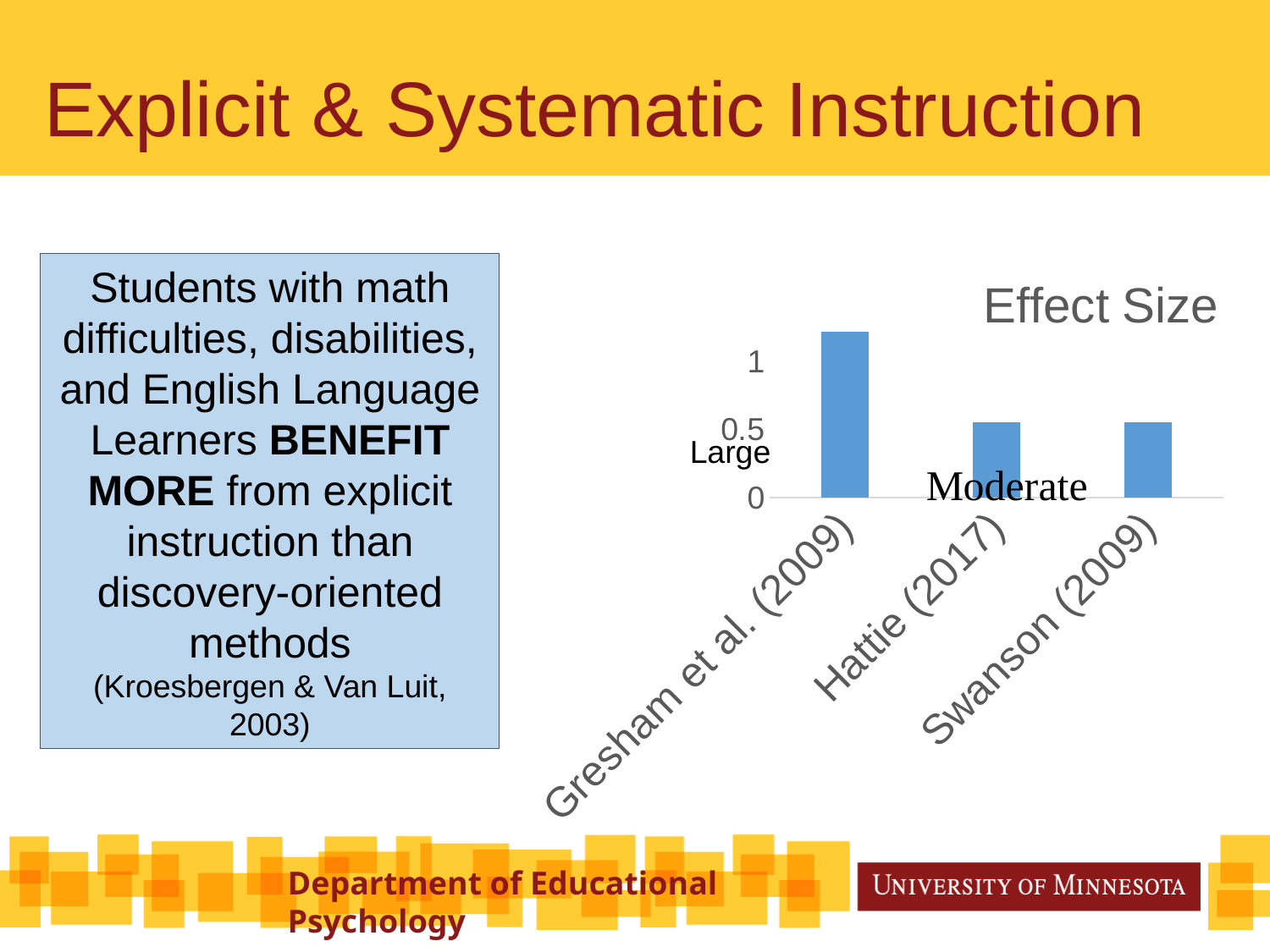
Which is larger, the effect size for Gresham et al. (2009) or for Swanson (2009)? Gresham et al. (2009) Is the effect size for Swanson (2009) greater or less than 1? less Which is larger, the effect size for Gresham et al. (2009) or for Hattie (2017)? Gresham et al. (2009) What is the highest value labelled on the vertical axis of the chart? 1 What is the title of the chart? Effect Size What kind of chart is shown on the slide? bar chart Is the effect size for Gresham et al. (2009) greater or less than 1? greater Is the effect size for Hattie (2017) greater or less than 1? less Which study has the highest effect size in the chart? Gresham et al. (2009) How many categories (studies) are shown in the Effect Size chart? 3